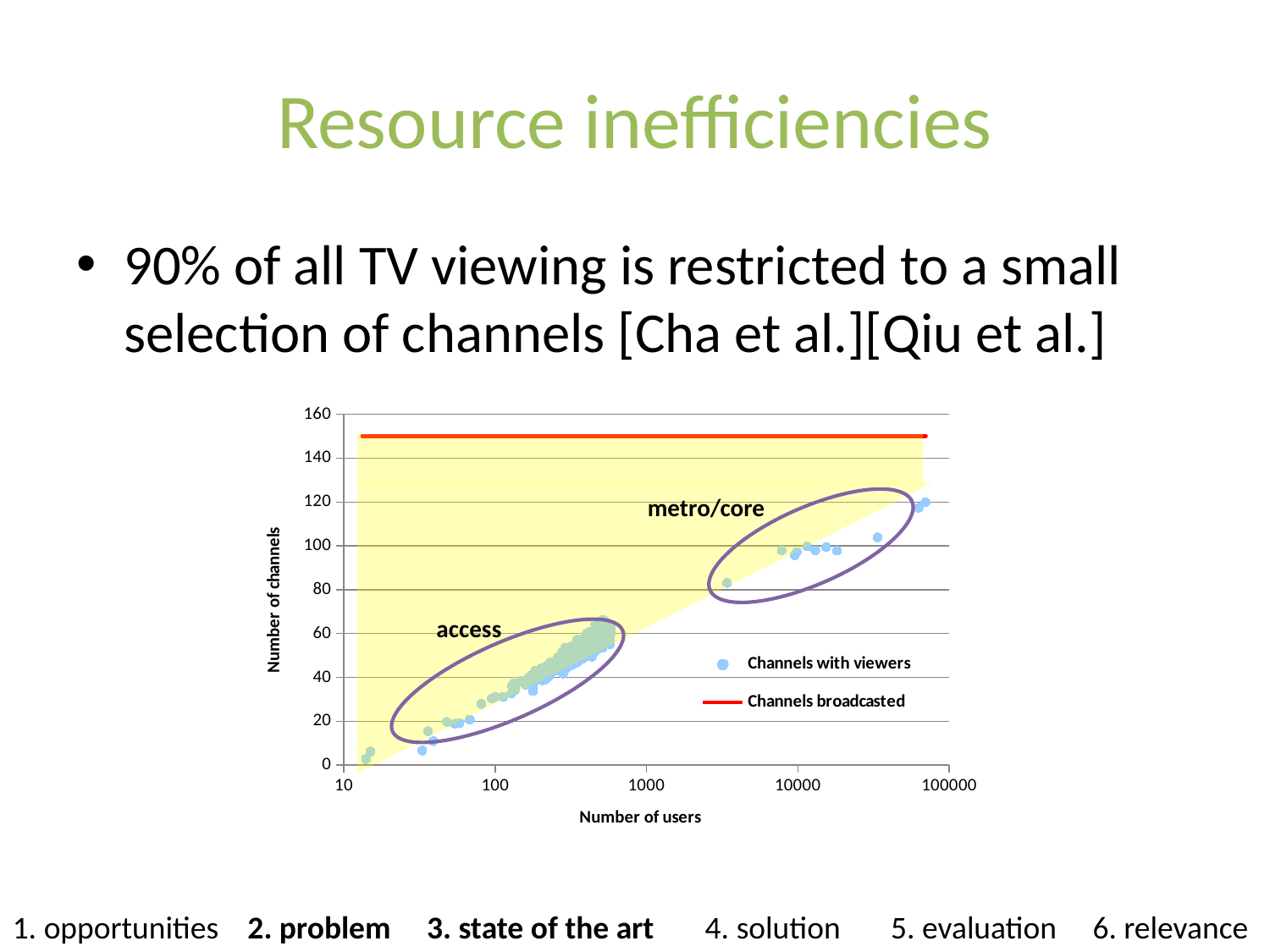
How many series does the chart's legend list? 2 Do the Channels with viewers values rise or fall as the number of users increases? rise Is the value of the Channels broadcasted line greater or less than 160? less What are the two entries in the chart's legend? Channels with viewers; Channels broadcasted Is the highest Channels with viewers point, near 70000 users, greater or less than 100? greater Which series has higher values across the chart, Channels broadcasted or Channels with viewers? Channels broadcasted Is the value of the Channels broadcasted line greater or less than 140? greater What kind of chart is shown on the slide? scatter chart What is the title of the chart's horizontal axis? Number of users